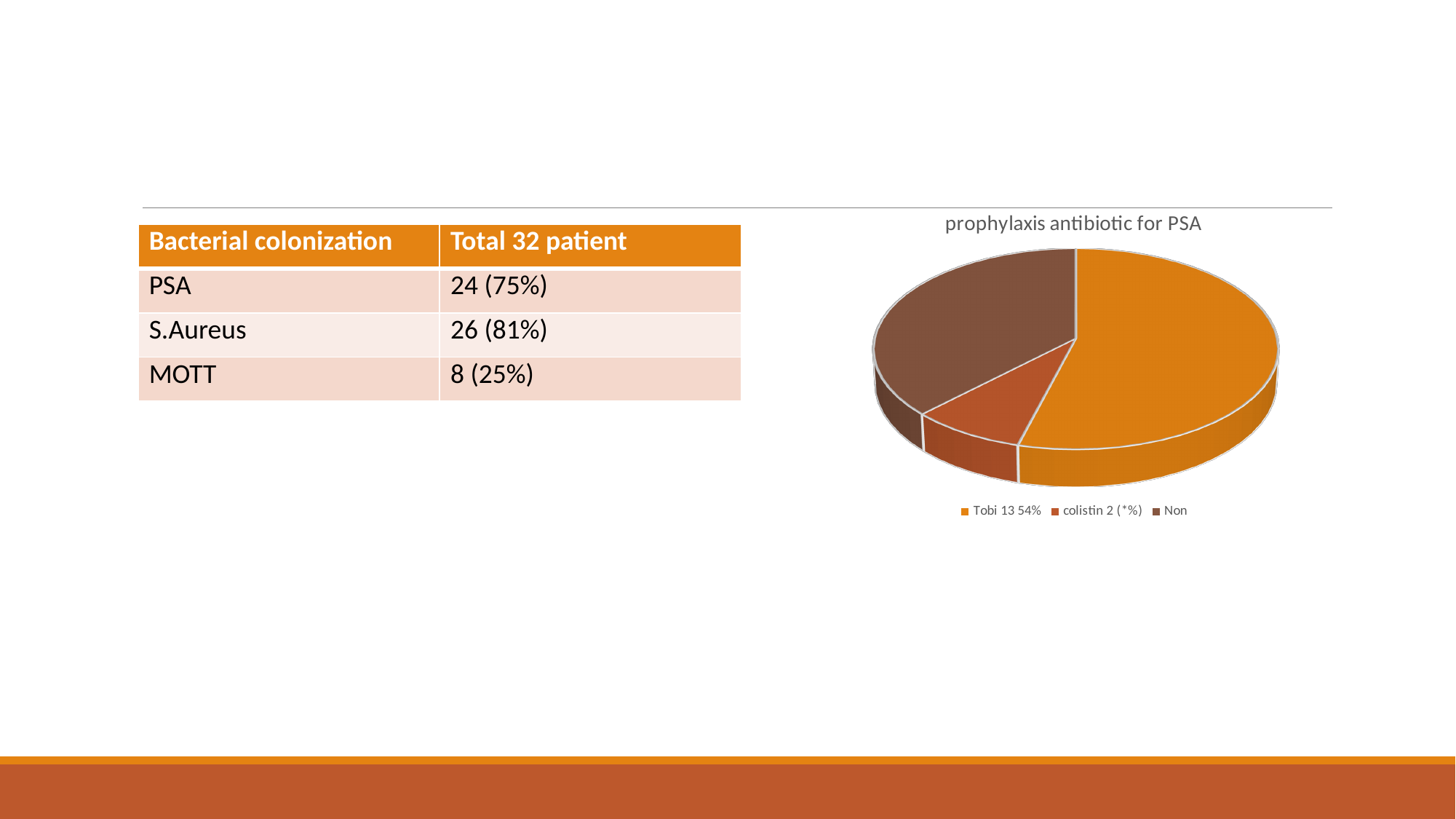
Which slice of the pie chart is the smallest? colistin Which slice of the pie chart is the largest? Tobi What count is shown for colistin in the pie chart's legend? 2 What percentage is shown for Tobi in the pie chart's legend? 54% How many entries does the pie chart's legend list? 3 What count is shown for Tobi in the pie chart's legend? 13 How many slices does the pie chart have? 3 What colour is the Tobi slice in the pie chart? orange In the pie chart, which slice is larger, Non or colistin? Non What kind of chart is shown on the slide? pie chart What is the title of the pie chart? prophylaxis antibiotic for PSA In the pie chart, which slice is larger, Tobi or Non? Tobi